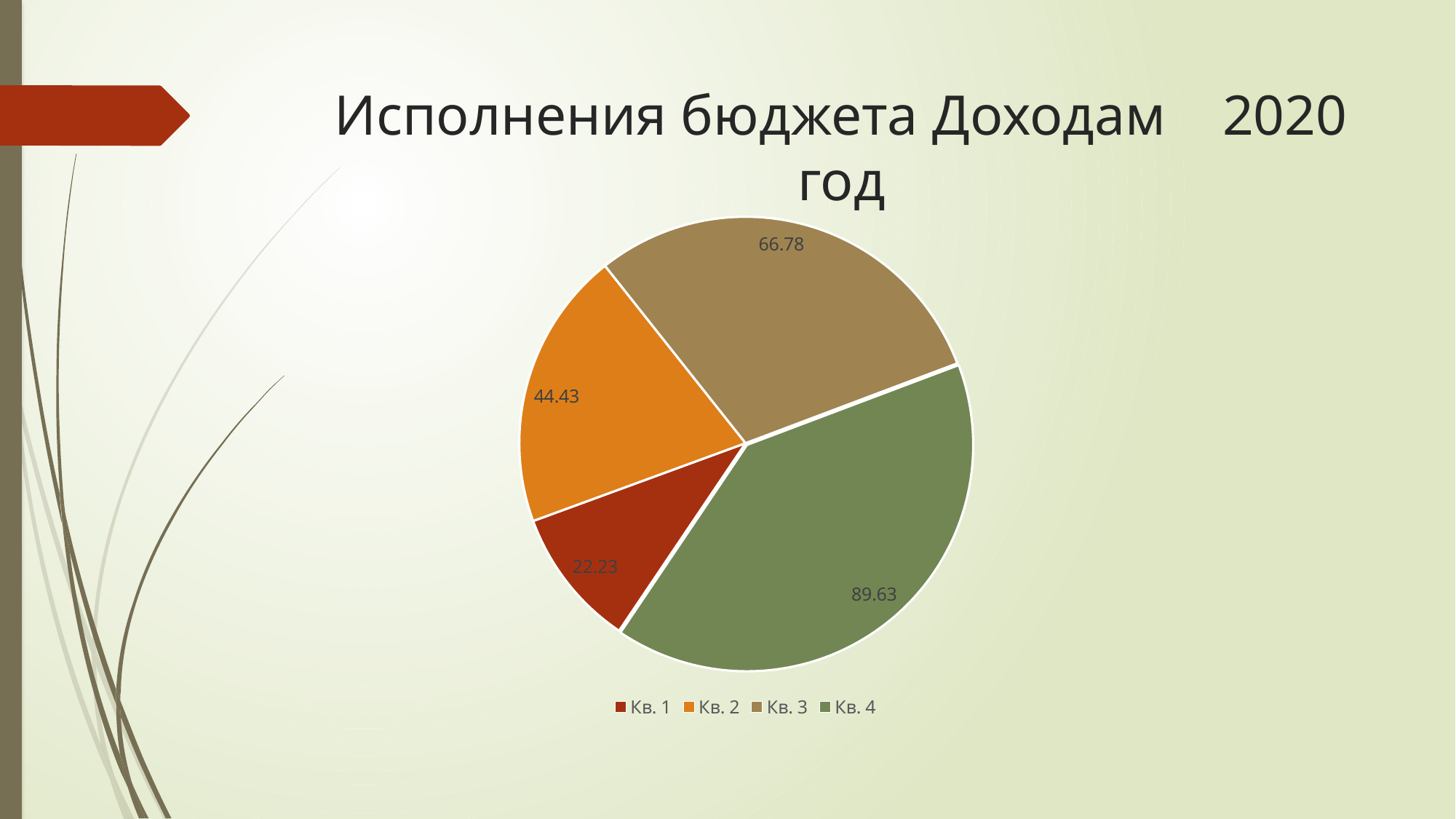
What type of chart is shown on the slide? pie chart What is the value for Кв. 2? 44.43 What is the value for Кв. 3? 66.78 What is the value for Кв. 4? 89.63 What is the difference between the values for Кв. 3 and Кв. 2? 22.35 Which is larger, the value for Кв. 2 or the value for Кв. 3? Кв. 3 How many categories does the pie chart have? 4 What is the value for Кв. 1? 22.23 Which category has the largest slice of the pie? Кв. 4 Which category has the smallest slice of the pie? Кв. 1 What is the difference between the values for Кв. 4 and Кв. 1? 67.40 What is the title of the chart on the slide? Исполнения бюджета Доходам 2020 год